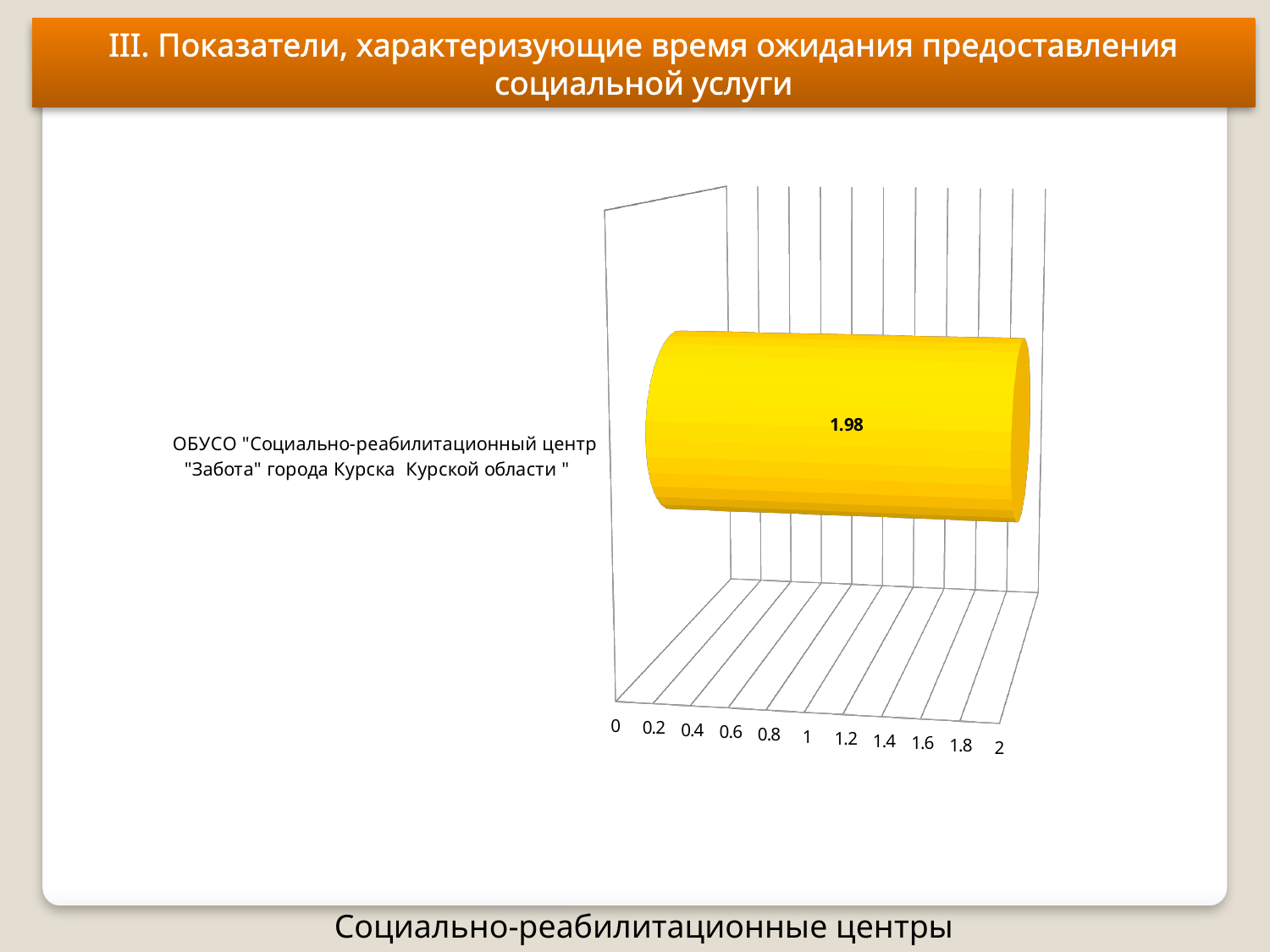
Is the value for ОБУСО "Социально-реабилитационный центр "Забота" greater or less than 2? less What kind of chart is shown on the slide? bar chart What is the value shown for ОБУСО "Социально-реабилитационный центр "Забота" города Курска Курской области"? 1.98 What is the highest value shown on the value axis of the chart? 2 Which category has the highest value in the chart? ОБУСО "Социально-реабилитационный центр "Забота" города Курска Курской области" Is the value for ОБУСО "Социально-реабилитационный центр "Забота" greater or less than 1? greater What colour is the bar in the chart? yellow How many categories are plotted in the chart? 1